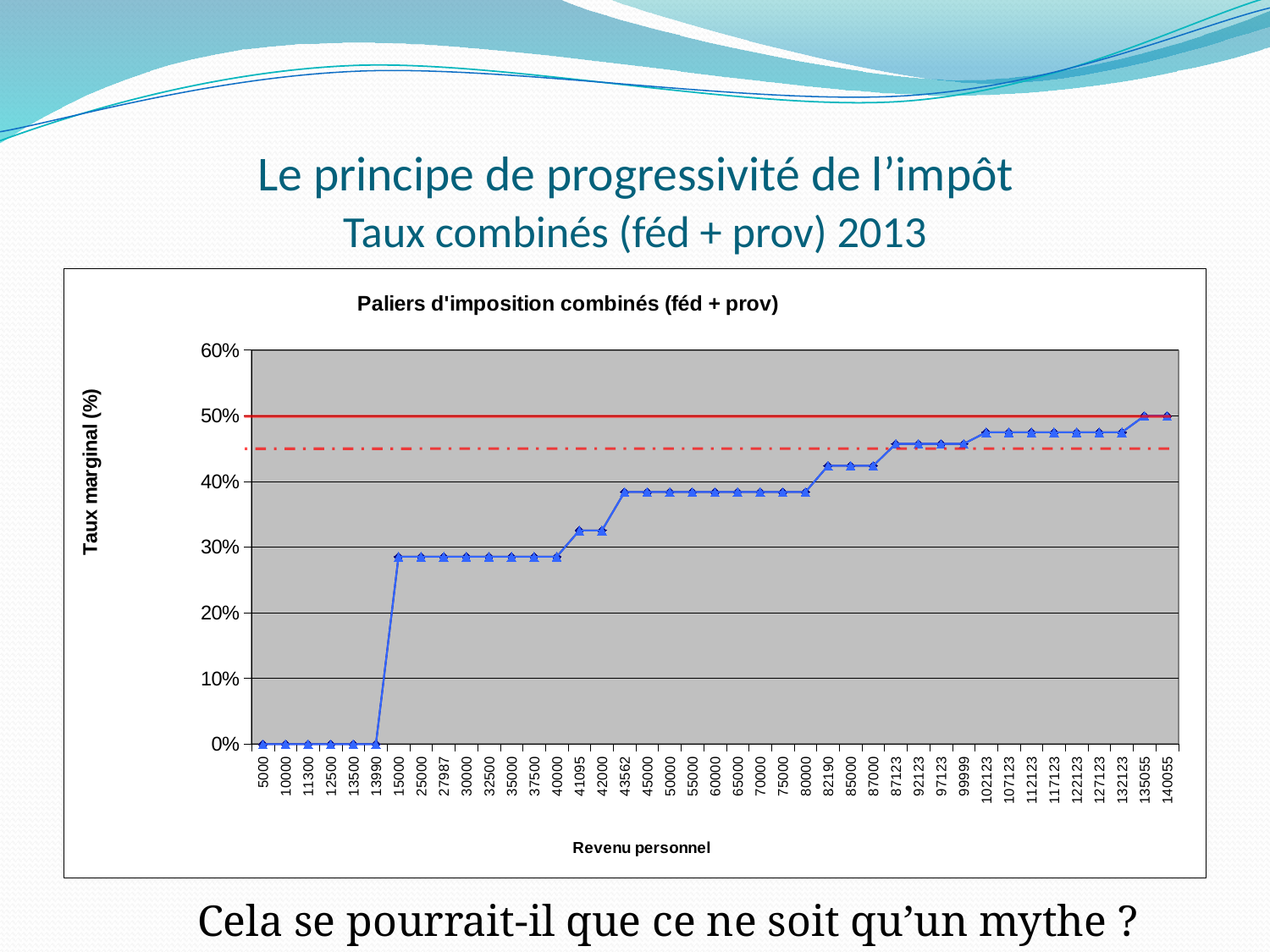
Is the value for a personal income of 102123 greater or less than 50%? less What kind of chart is shown on the slide? line chart Is the value for a personal income of 15000 greater or less than 20%? greater Is the value for a personal income of 50000 greater or less than 40%? less What is the title of the chart? Paliers d'imposition combinés (féd + prov) Do the plotted values generally rise or fall as personal income increases along the x axis? rise Which has a higher marginal tax rate, a personal income of 15000 or 50000? 50000 What is the label of the vertical axis of the chart? Taux marginal (%) What is the marginal tax rate plotted for a personal income of 13990? 0% What is the marginal tax rate plotted for a personal income of 5000? 0%